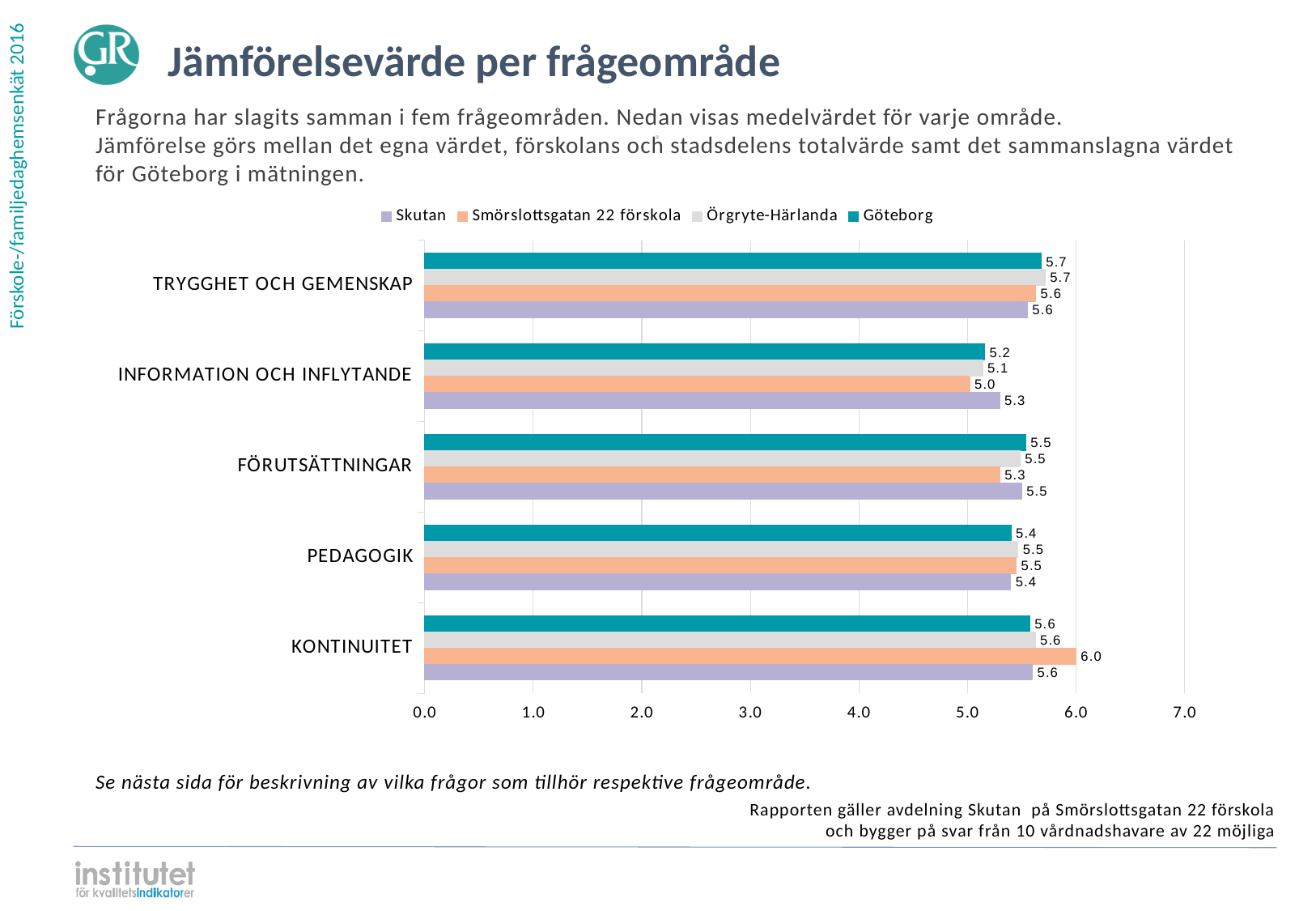
What is the value for Skutan in INFORMATION OCH INFLYTANDE? 5.3 What is the value for Smörslottsgatan 22 förskola in KONTINUITET? 6.0 In FÖRUTSÄTTNINGAR, which is larger: the value for Skutan or the value for Smörslottsgatan 22 förskola? Skutan Which category has the lowest value for Smörslottsgatan 22 förskola? INFORMATION OCH INFLYTANDE Which series is shown in teal in the legend? Göteborg How many series does the legend list? 4 What is the difference between the Smörslottsgatan 22 förskola value and the Skutan value in KONTINUITET? 0.4 Which category has the highest value for Smörslottsgatan 22 förskola? KONTINUITET What is the value for Göteborg in TRYGGHET OCH GEMENSKAP? 5.7 What type of chart is shown on the slide? Bar chart How many question areas (categories) are shown on the chart? 5 What is the value for Örgryte-Härlanda in PEDAGOGIK? 5.5